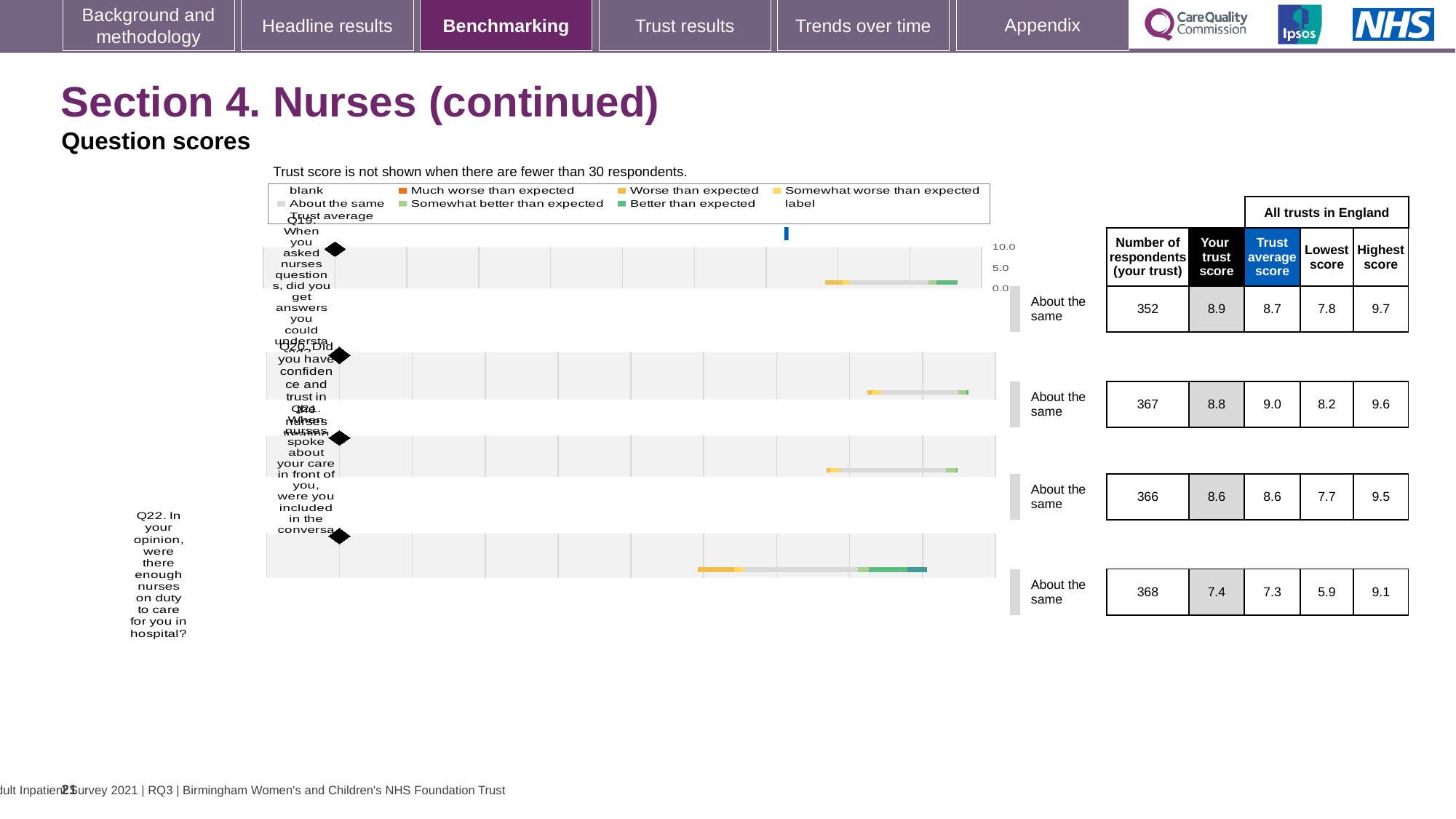
What is the trust average score for Q21? 8.6 Which question has the highest 'Your trust score'? Q19 Which question has the lowest 'Your trust score'? Q22 How many questions (Q19 to Q22) are plotted in the chart? 4 What benchmark category is shown for Q22? About the same What is the 'Your trust score' for Q22 (enough nurses on duty)? 7.4 How many respondents from your trust answered Q19? 352 For Q20, which is larger: your trust score or the trust average score? Trust average score For Q22, what is the difference between the highest score and the lowest score across all trusts in England? 3.2 What is the lowest score across all trusts in England for Q20? 8.2 What kind of chart is used to show the question scores on this slide? bar chart